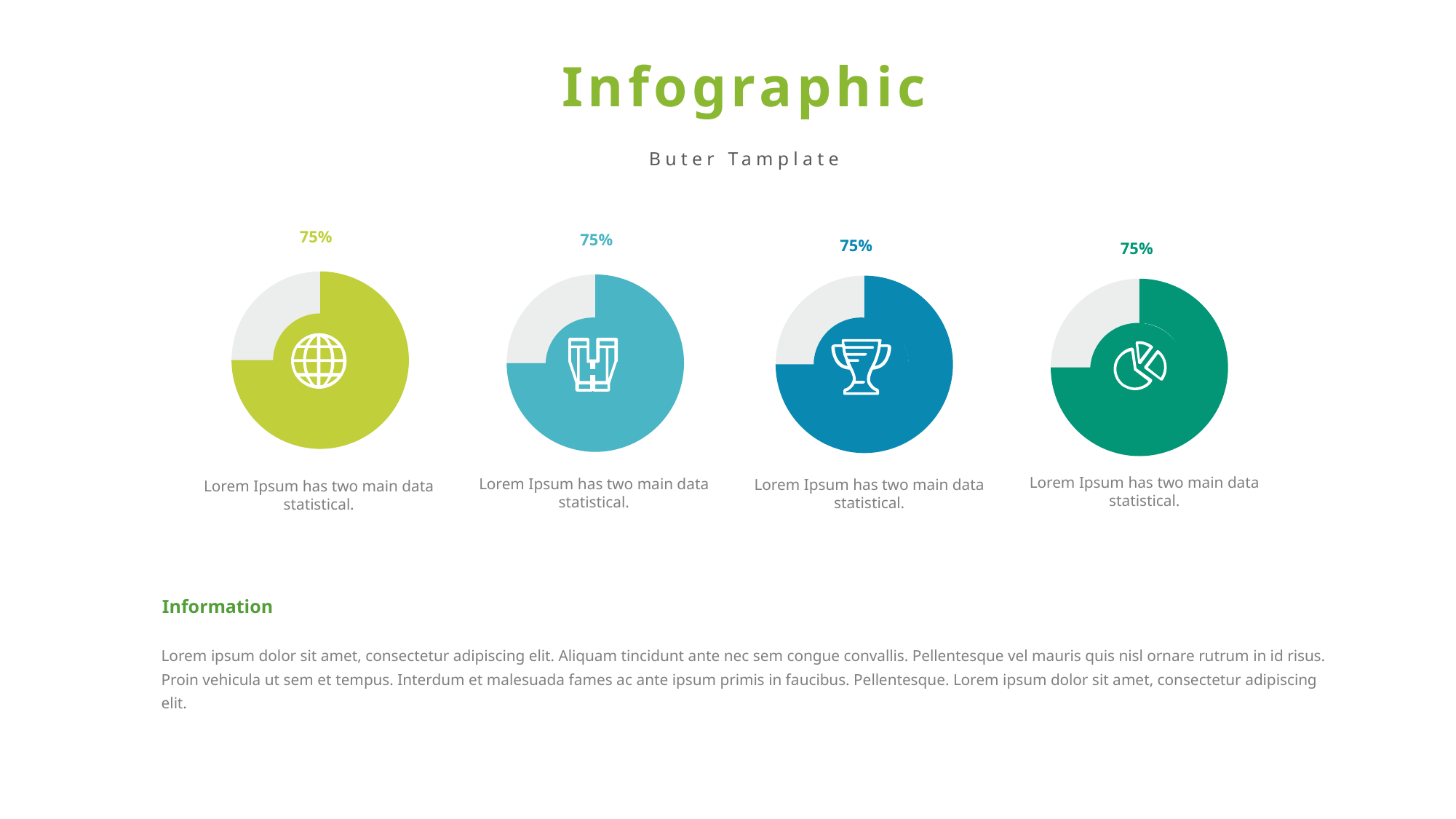
Do all four pie charts show the same percentage value? Yes What share of the rightmost pie chart is left grey (unfilled)? 25% What value is printed above the third pie chart from the left (with the trophy icon)? 75% What share of the leftmost pie chart does the coloured slice represent? 75% Is the value shown for the third pie chart from the left greater or less than 50%? greater How many pie charts are shown on the slide? 4 What is the title at the top of the slide above the pie charts? Infographic What value is printed above the leftmost pie chart (with the globe icon)? 75% What value is printed above the second pie chart from the left (with the binoculars icon)? 75% What value is printed above the rightmost pie chart (with the pie-chart icon)? 75% What colour is the filled slice of the leftmost pie chart? green What kind of chart is used for each of the four graphics in the middle of the slide? pie chart